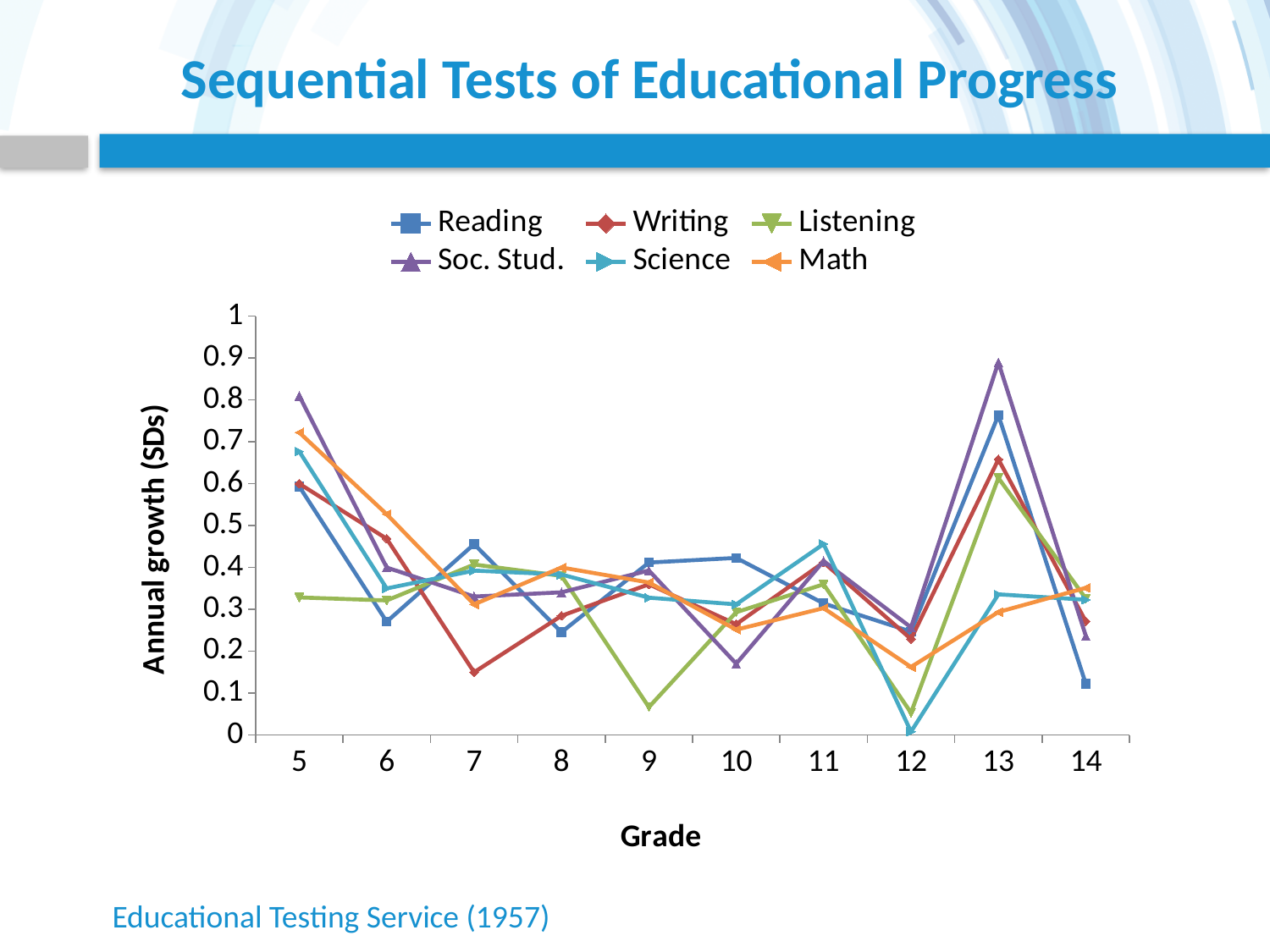
At which grade does the Soc. Stud. series reach its highest value? 13 Is the value for Science at grade 12 greater or less than 0.1? less Does the Math series rise or fall from grade 5 to grade 7? fall At which grade does the Writing series reach its lowest value? 7 Is the value for Soc. Stud. at grade 13 greater or less than 0.8? greater At which grade does the Science series reach its lowest value? 12 What kind of chart is shown on the slide? line chart At grade 5, which series has the larger value, Soc. Stud. or Listening? Soc. Stud. Is the value for Reading at grade 14 greater or less than 0.2? less How many series does the legend list? 6 How many grade levels are plotted along the x axis? 10 What is the title of the y axis? Annual growth (SDs)